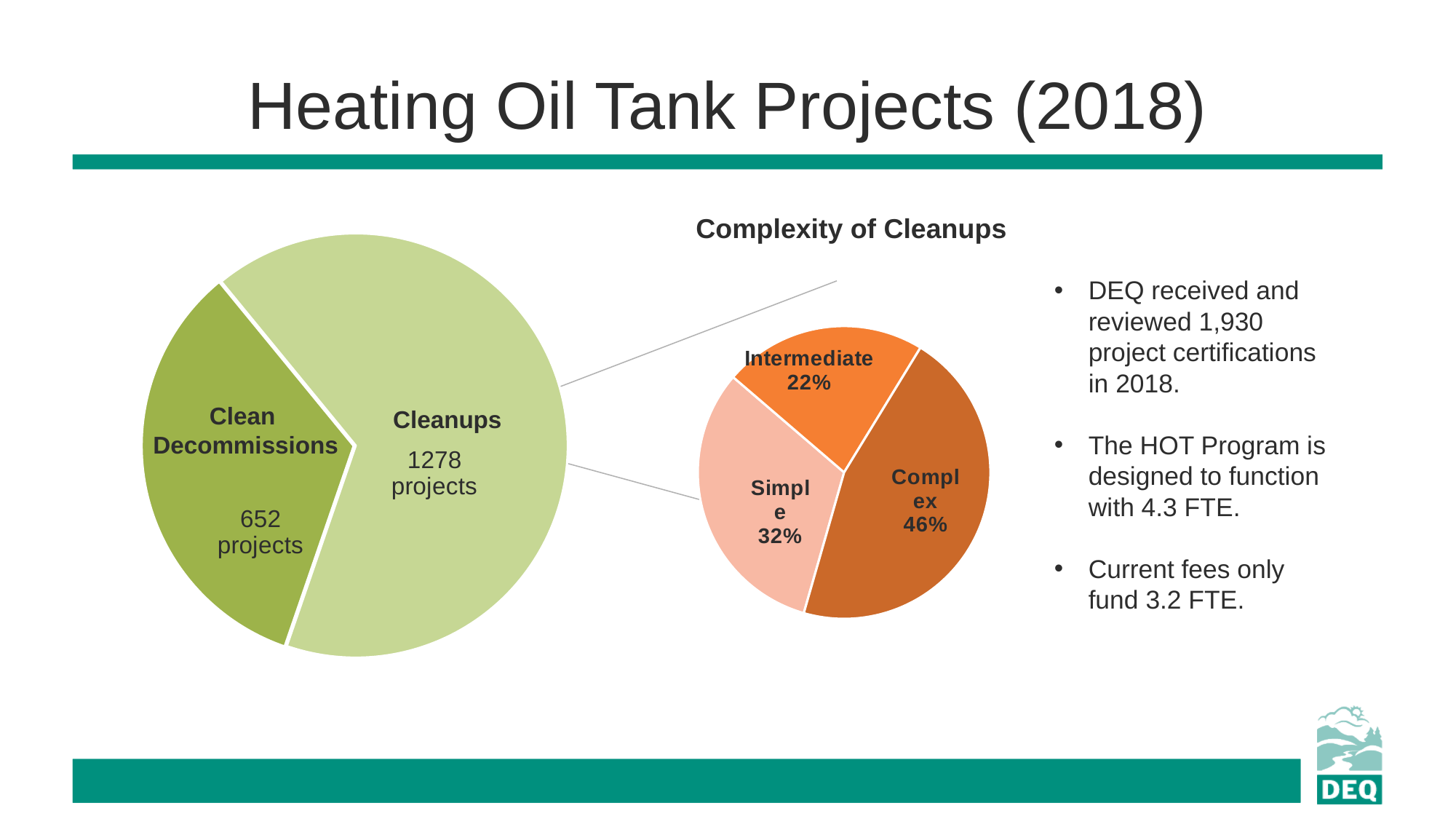
In the left pie chart, what is the difference in projects between Cleanups and Clean Decommissions? 626 In the left pie chart, which category has the larger number of projects? Cleanups In the left pie chart, how many projects were Cleanups? 1278 projects In the Complexity of Cleanups chart, how many percentage points larger is Complex than Intermediate? 24 In the left pie chart, what is the total number of projects across both slices? 1930 In the left pie chart, how many projects were Clean Decommissions? 652 projects In the Complexity of Cleanups chart, how many categories are shown? 3 In the Complexity of Cleanups chart, what share is Complex? 46% What type of chart is the Complexity of Cleanups chart? Pie chart In the Complexity of Cleanups chart, what share is Simple? 32% In the Complexity of Cleanups chart, which category has the smallest share? Intermediate In the left pie chart, how many slices are there? 2